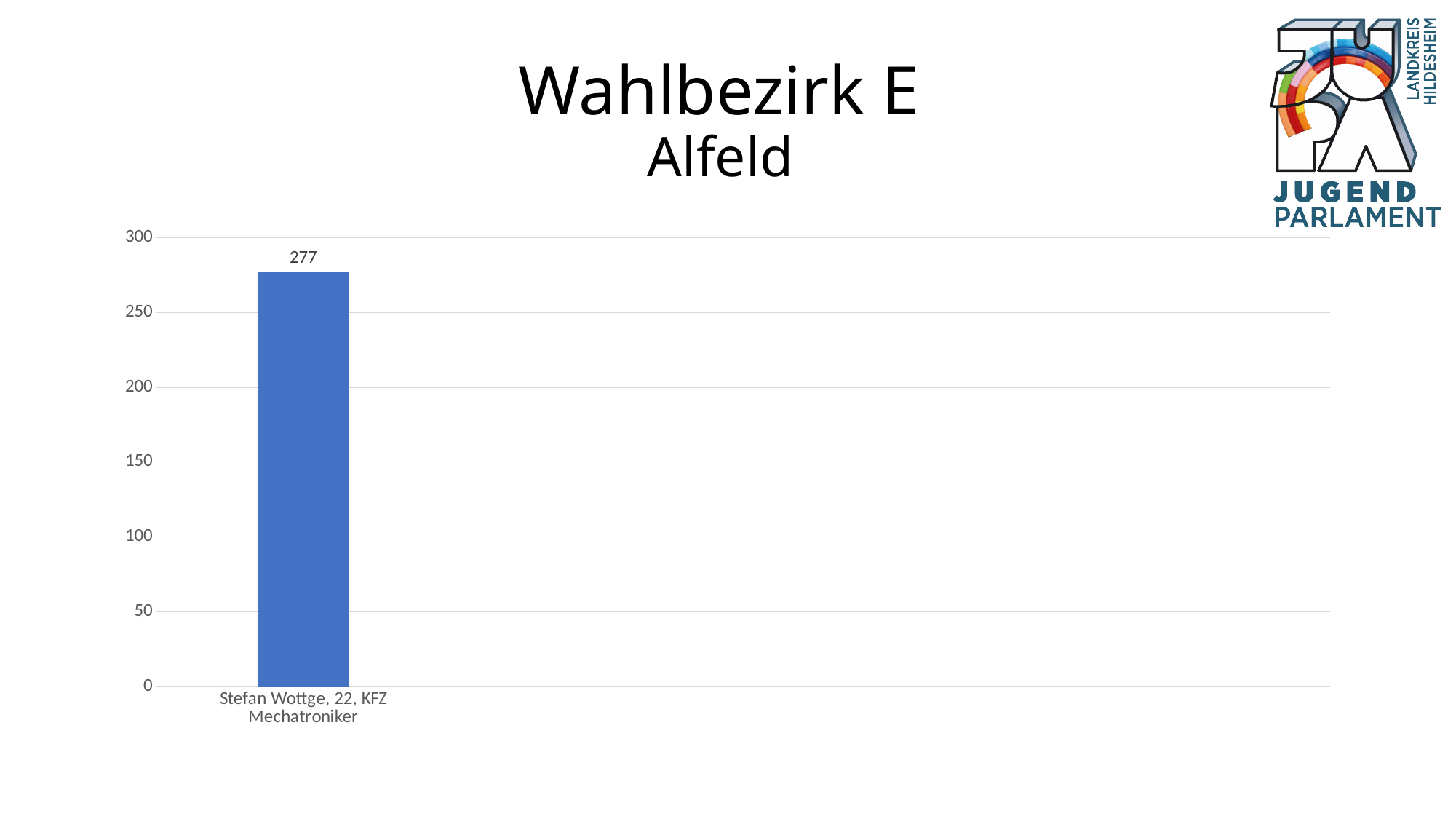
Which category has the highest value on the chart? Stefan Wottge, 22, KFZ Mechatroniker How many categories are plotted on the chart? 1 What is the highest value shown on the vertical axis? 300 Is the value for Stefan Wottge, 22, KFZ Mechatroniker greater or less than 300? less What kind of chart is shown on the slide? bar chart Is the value for Stefan Wottge, 22, KFZ Mechatroniker greater or less than 250? greater What value is shown for Stefan Wottge, 22, KFZ Mechatroniker? 277 What is the label of the only category on the x axis? Stefan Wottge, 22, KFZ Mechatroniker